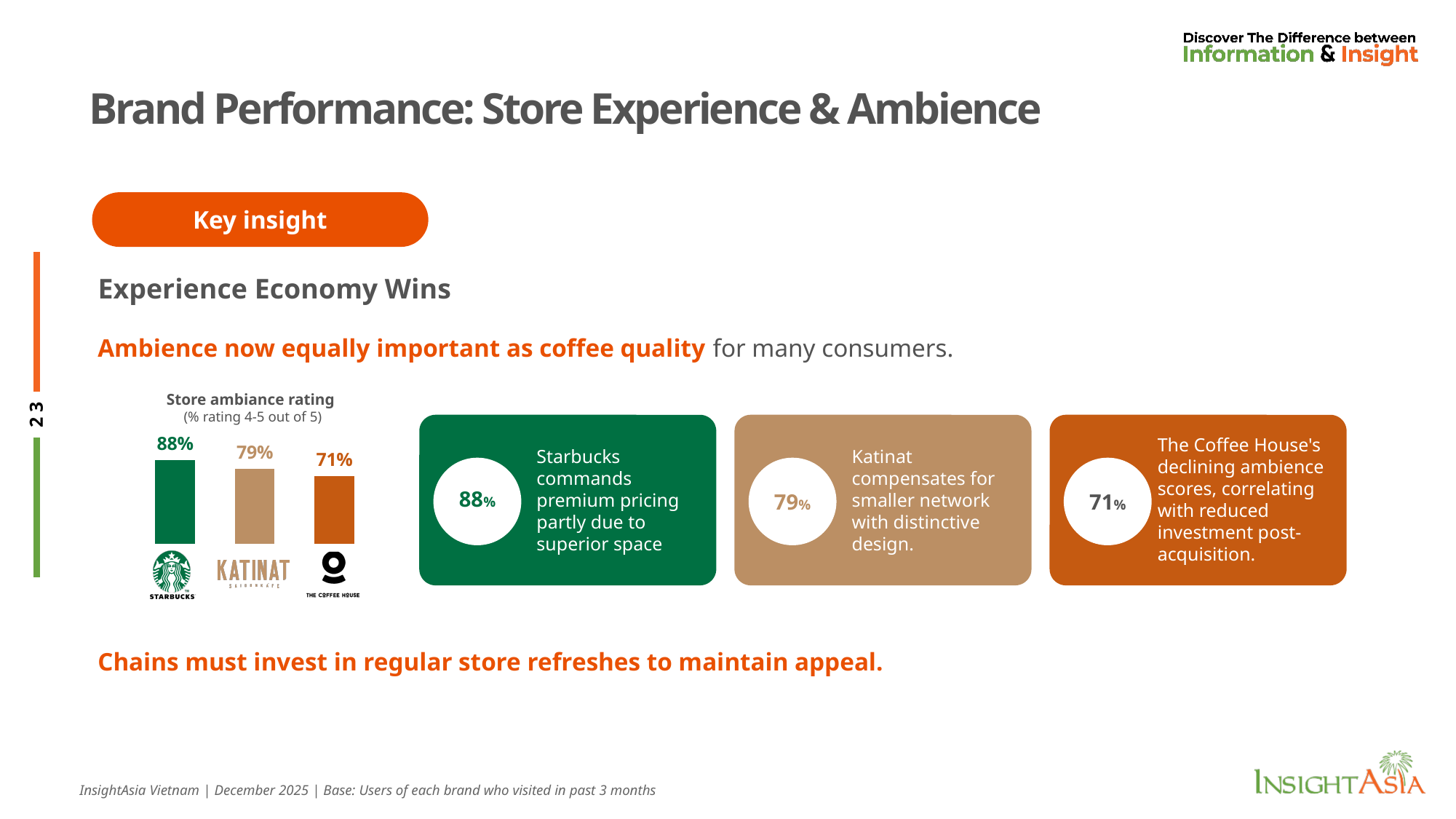
What is the store ambiance rating for Starbucks? 88% How many brands are shown in the store ambiance rating chart? 3 What is the difference between the store ambiance ratings of Katinat and The Coffee House? 8% Which has a higher store ambiance rating, Katinat or The Coffee House? Katinat What is the store ambiance rating for The Coffee House? 71% What is the title of the chart on the slide? Store ambiance rating What is the store ambiance rating for Katinat? 79% What type of chart is used to show the store ambiance rating? Bar chart What is the difference between the store ambiance ratings of Starbucks and The Coffee House? 17% Which brand has the highest store ambiance rating? Starbucks Do the store ambiance rating values rise or fall from left to right across the bars? Fall Which brand has the lowest store ambiance rating? The Coffee House